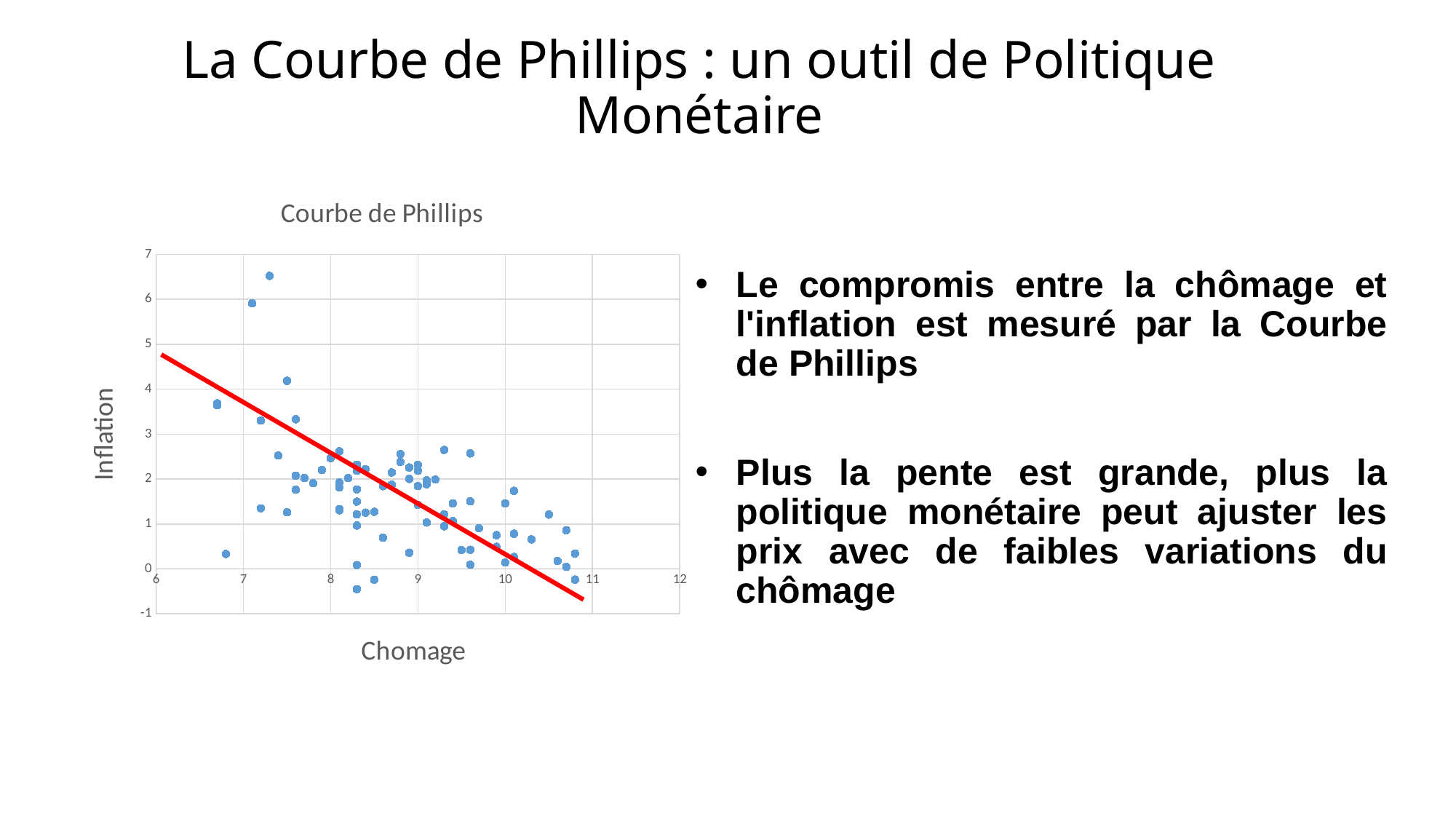
As Chomage increases along the x axis, does the red trend line rise or fall? Fall Is the Inflation value of the red trend line at Chomage 6 greater or less than 4? greater Is the Inflation value of the red trend line at Chomage 10 greater or less than 1? less What is the label of the x axis of the chart? Chomage What is the lowest value shown on the y axis of the chart? -1 Is the Inflation value of the lowest plotted point greater or less than 0? less What is the title of the chart? Courbe de Phillips What kind of chart is shown on the slide? Scatter chart